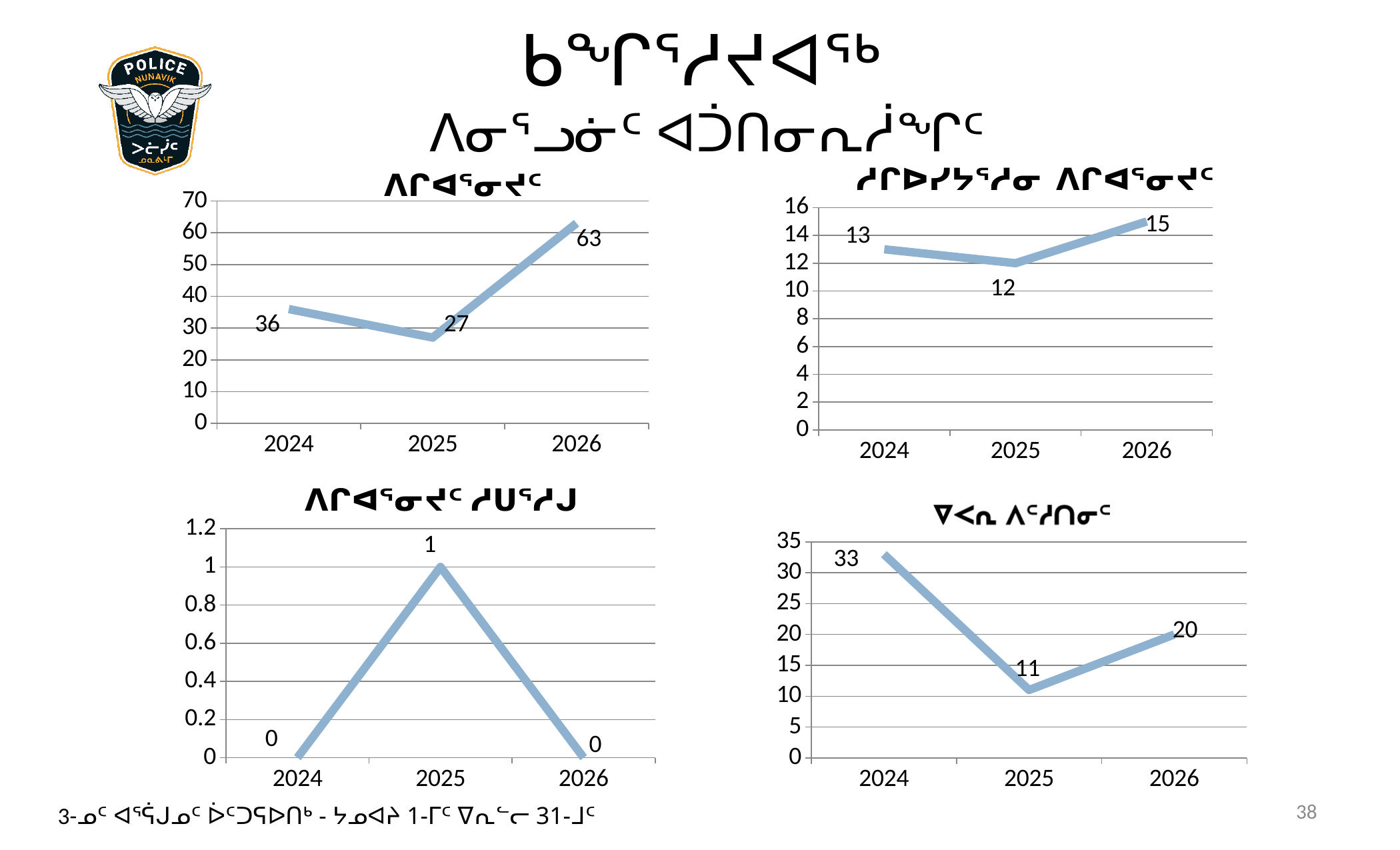
In the top-left chart, what is the difference between the 2026 and 2024 values? 27 In the top-left chart, which year has the lowest value? 2025 In the top-right chart, how many data points are plotted? 3 In the top-right chart, which year has the highest value? 2026 In the bottom-right chart, what is the value for 2024? 33 What kind of chart is the bottom-right chart? Line chart In the bottom-right chart, what is the difference between the 2024 and 2025 values? 22 In the top-right chart, what is the value for 2025? 12 In the bottom-left chart, what is the value for 2024? 0 In the top-left chart, what is the value for 2026? 63 In the bottom-right chart, which is larger, the value for 2025 or the value for 2026? 2026 In the bottom-left chart, what is the value for 2025? 1